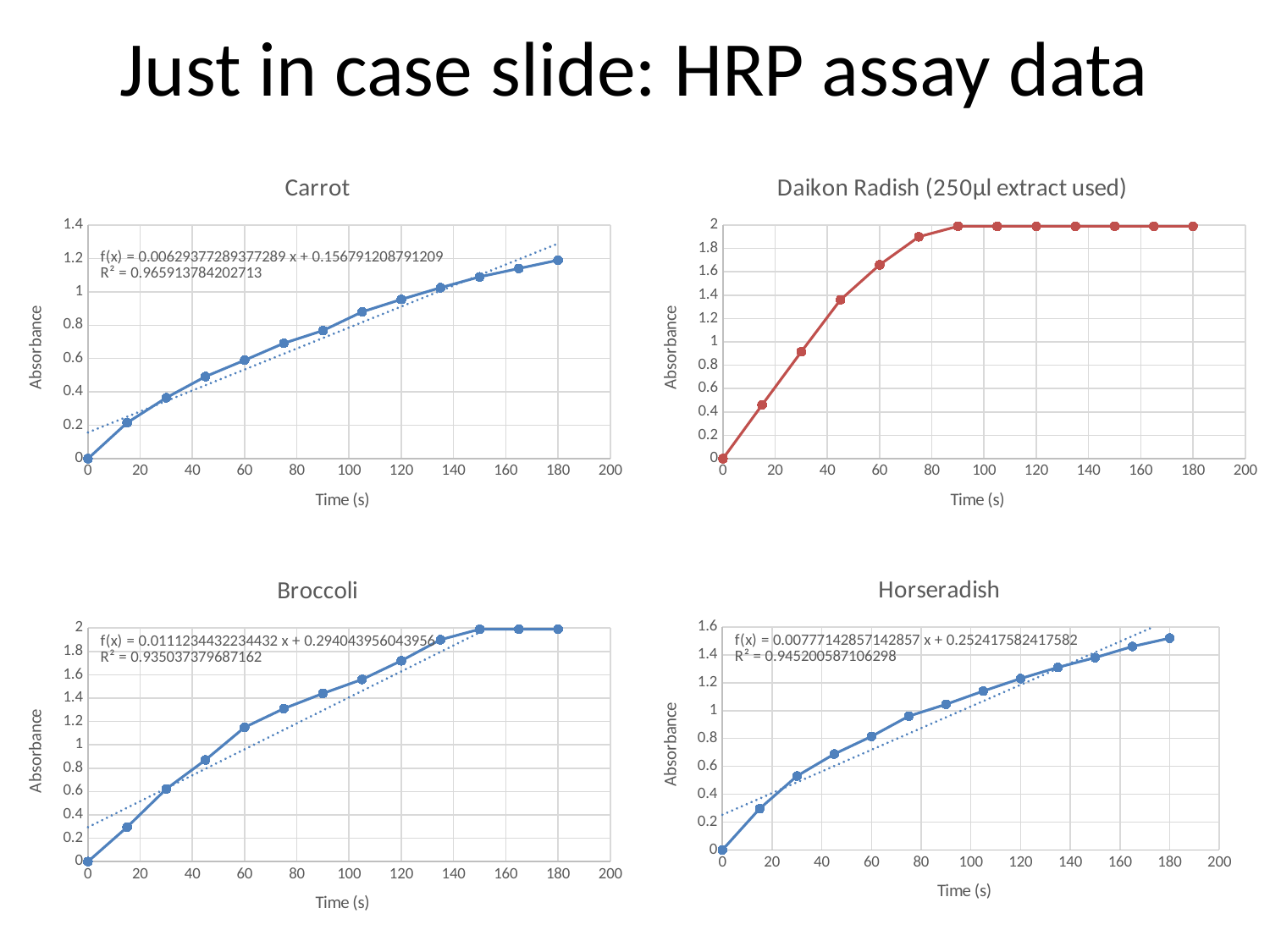
On the Broccoli chart, is the absorbance at 60 s greater or less than 1? greater On the Horseradish chart, does absorbance rise or fall as time increases? rise On the Horseradish chart, is the absorbance at 30 s greater or less than 0.4? greater How many data points are plotted on the Daikon Radish (250µl extract used) chart? 13 On the Carrot chart, is the absorbance at 180 s greater or less than 1? greater Which is larger at 60 s: the absorbance on the Broccoli chart or on the Horseradish chart? Broccoli What kind of chart is the Carrot chart? line chart On the Carrot chart, what is the absorbance at time 0 s? 0 What R² value is shown on the Carrot chart? 0.965913784202713 On the Carrot chart, at which time is the absorbance highest? 180 s